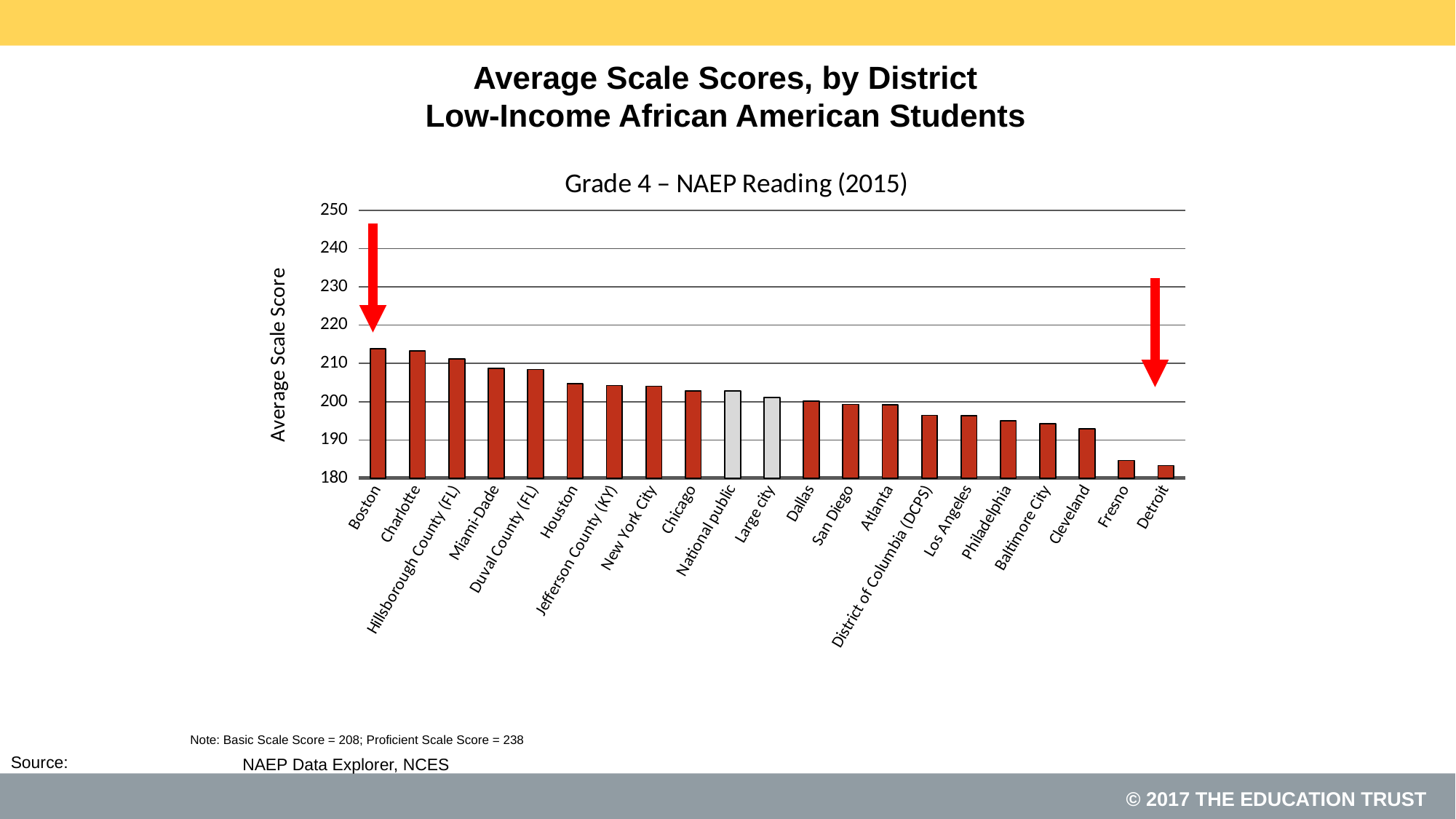
Which has a higher average scale score, Houston or Cleveland? Houston Do the values rise or fall moving from left to right along the x axis? fall How many districts or groups are plotted along the x axis? 21 Is the value for Cleveland greater or less than 190? greater Is the value for Detroit greater or less than 190? less Is the value for Los Angeles greater or less than 200? less What is the label on the vertical axis of the chart? Average Scale Score What kind of chart is shown on the slide? bar chart Which district has the lowest average scale score? Detroit Which district has the highest average scale score? Boston